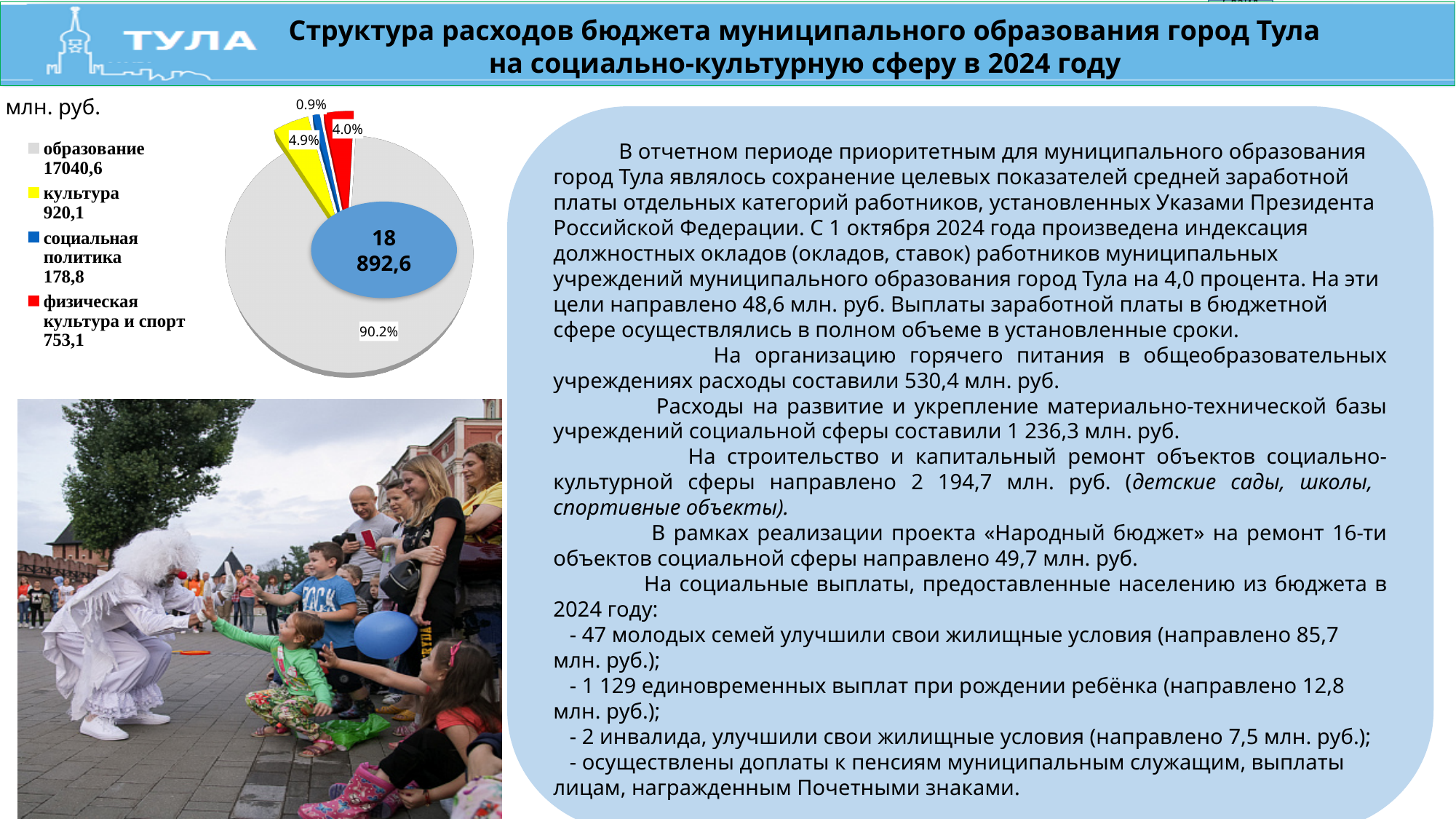
What percentage share of the pie does образование have? 90.2% What percentage share of the pie does культура have? 4.9% How many categories does the pie chart's legend list? 4 What value is shown in the legend for физическая культура и спорт? 753,1 What value is shown in the legend for образование? 17040,6 What kind of chart is shown on the slide? pie chart What value is shown in the legend for культура? 920,1 What value is shown in the legend for социальная политика? 178,8 Which is larger, the value for культура or the value for физическая культура и спорт? культура What total value is printed in the centre of the pie chart? 18 892,6 Which category has the largest share of the pie? образование Which category has the smallest share of the pie? социальная политика